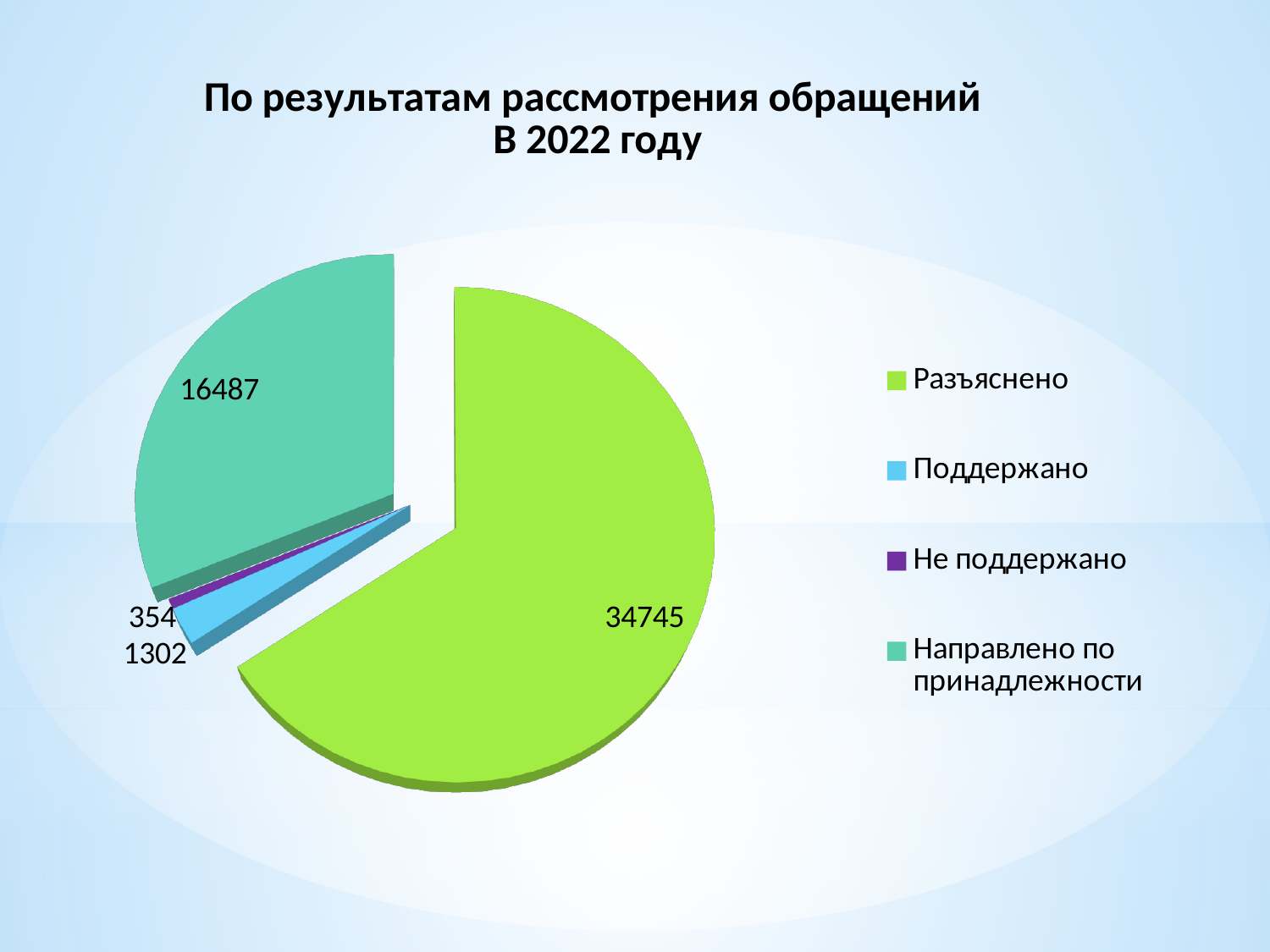
What is the value for Направлено по принадлежности? 16487 Which is larger, Поддержано or Не поддержано? Поддержано Which category has the smallest slice? Не поддержано Which category has the largest slice? Разъяснено How many categories does the legend list? 4 What is the value for Поддержано? 1302 What is the difference between the values for Поддержано and Не поддержано? 948 What is the value for Не поддержано? 354 What type of chart is shown on the slide? Pie chart What is the difference between the values for Разъяснено and Направлено по принадлежности? 18258 What is the value for Разъяснено? 34745 What is the title of the chart? По результатам рассмотрения обращений В 2022 году